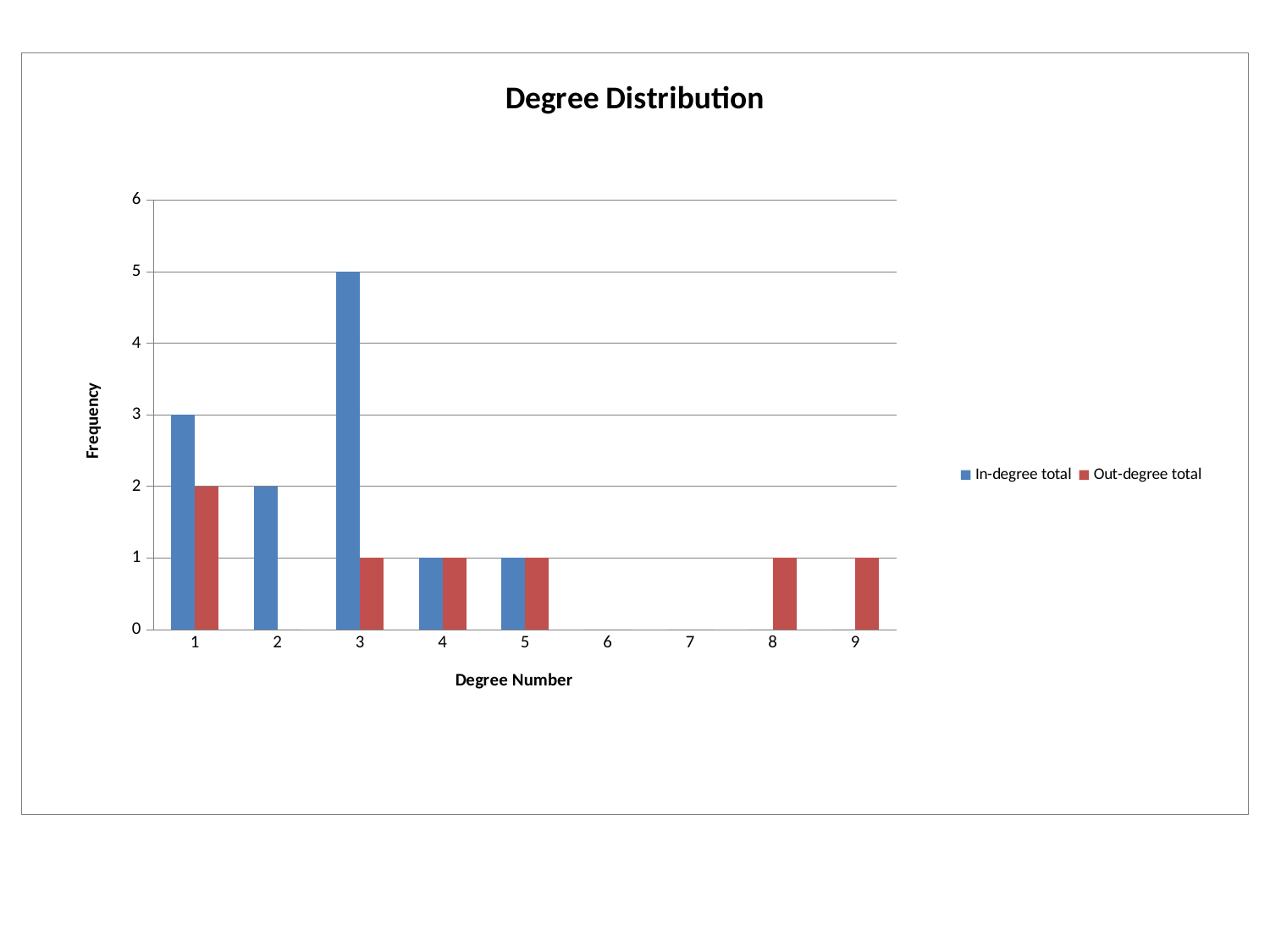
How many series does the legend list? 2 What type of chart is shown on the slide? Bar chart What is the In-degree total for degree number 3? 5 How many degree number categories are shown on the x axis? 9 At degree number 1, which is larger: the In-degree total or the Out-degree total? In-degree total What is the Out-degree total for degree number 1? 2 What is the In-degree total for degree number 1? 3 What is the difference between the In-degree total and the Out-degree total at degree number 3? 4 What is the Out-degree total for degree number 8? 1 Is the In-degree total for degree number 3 greater or less than 4? greater Which degree number has the highest Out-degree total? 1 Which degree number has the highest In-degree total? 3